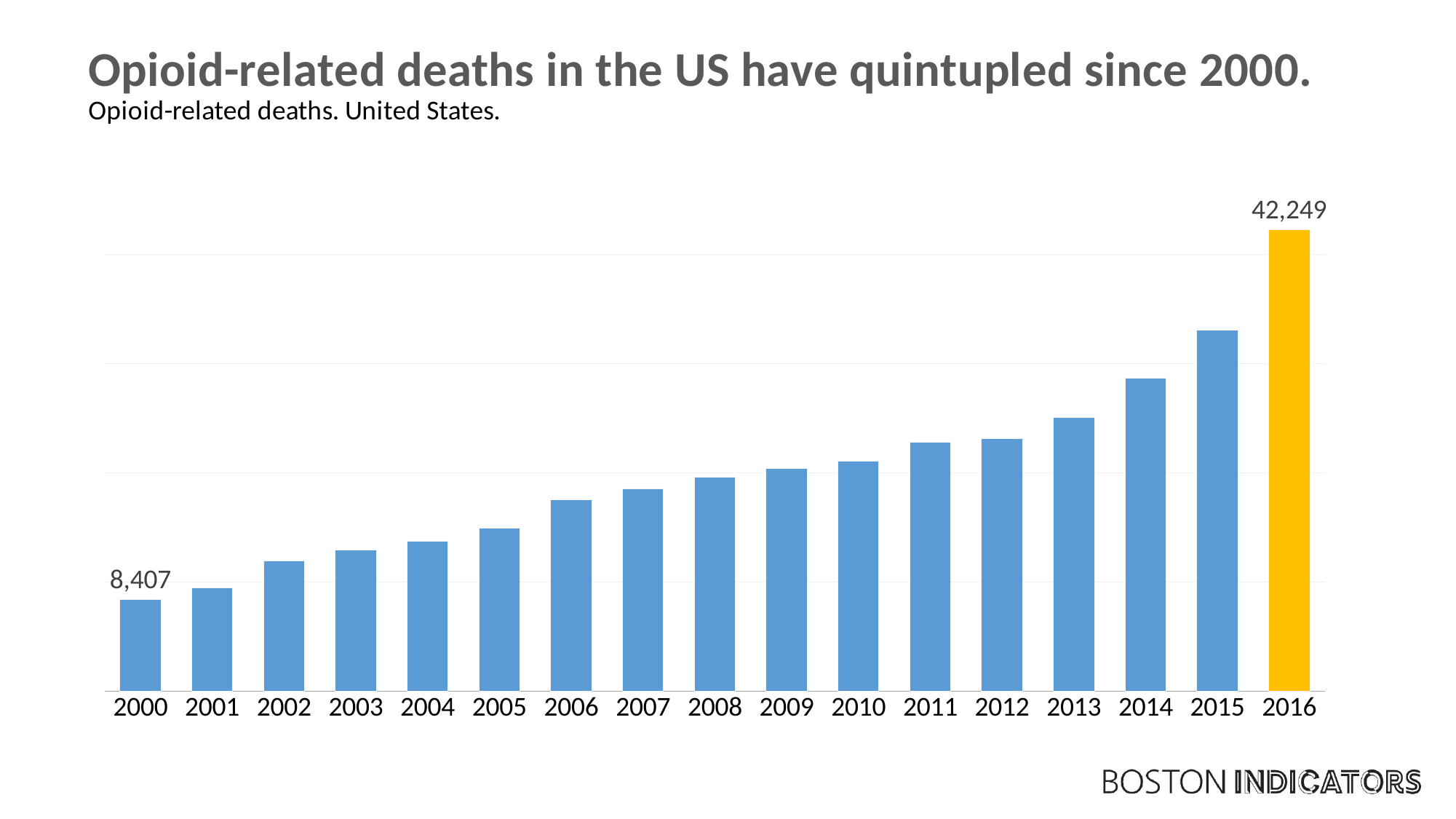
Which is larger, the value for 2015 or the value for 2014? 2015 What is the value for 2000? 8,407 How many years are shown on the x axis? 17 Which year has the lowest number of opioid-related deaths? 2000 Do the values rise or fall from 2000 to 2016? Rise What kind of chart is this? Bar chart What is the title of the slide? Opioid-related deaths in the US have quintupled since 2000. What is the value for 2016? 42,249 Which is larger, the value for 2005 or the value for 2010? 2010 What is the difference between the values for 2016 and 2000? 33,842 Which year's bar is coloured differently from the others? 2016 Which year has the highest number of opioid-related deaths? 2016